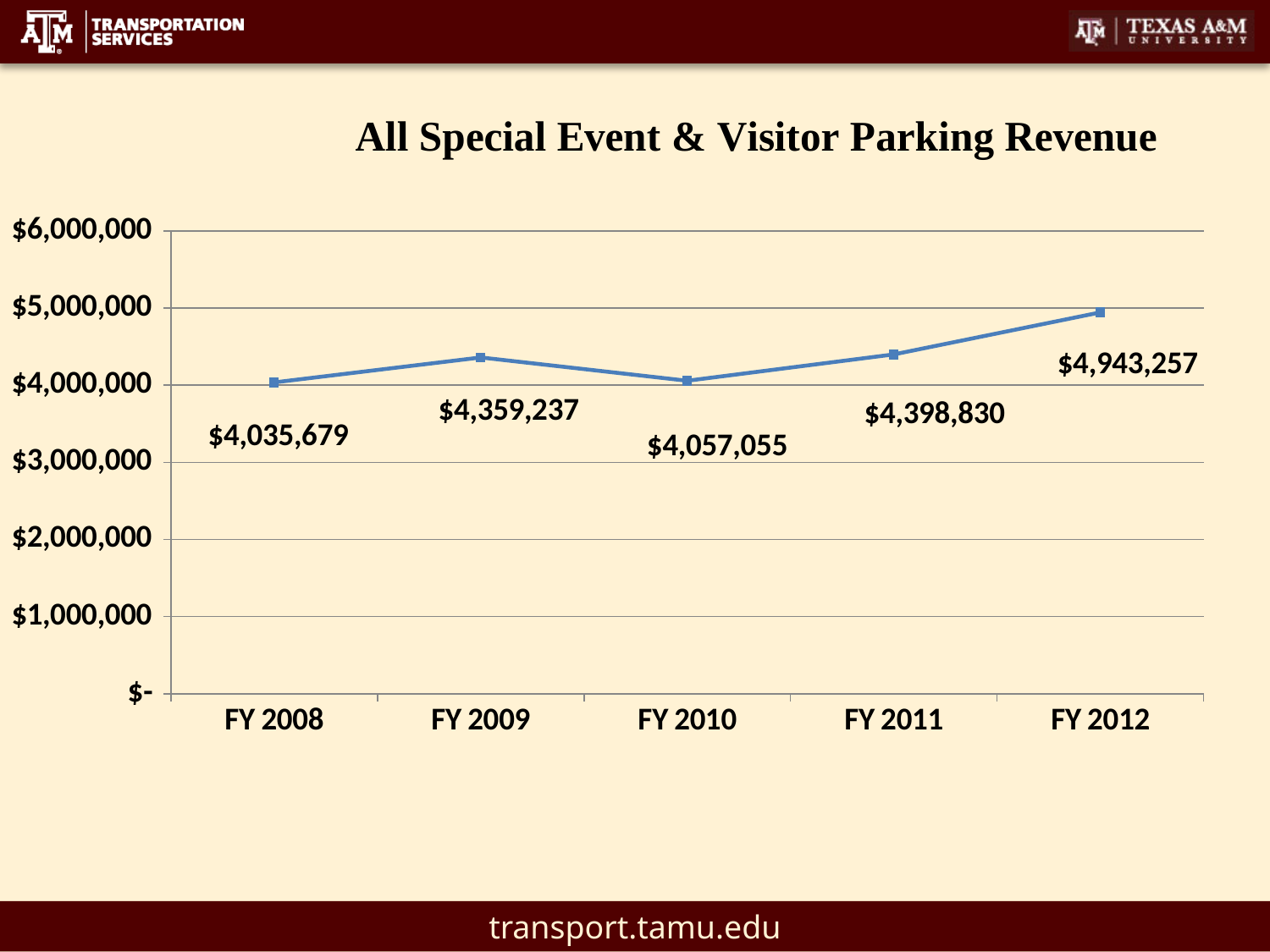
What is the revenue for FY 2012? $4,943,257 Is the value for FY 2012 greater or less than $5,000,000? less What kind of chart is shown on the slide? line chart Which fiscal year has the highest revenue? FY 2012 What is the difference in revenue between FY 2012 and FY 2008? $907,578 What is the difference in revenue between FY 2012 and FY 2011? $544,427 How many fiscal years are plotted on the chart? 5 Which fiscal year has the lowest revenue? FY 2008 What is the revenue for FY 2011? $4,398,830 What is the revenue for FY 2010? $4,057,055 Which is larger, the revenue for FY 2009 or FY 2010? FY 2009 What is the revenue for FY 2008? $4,035,679